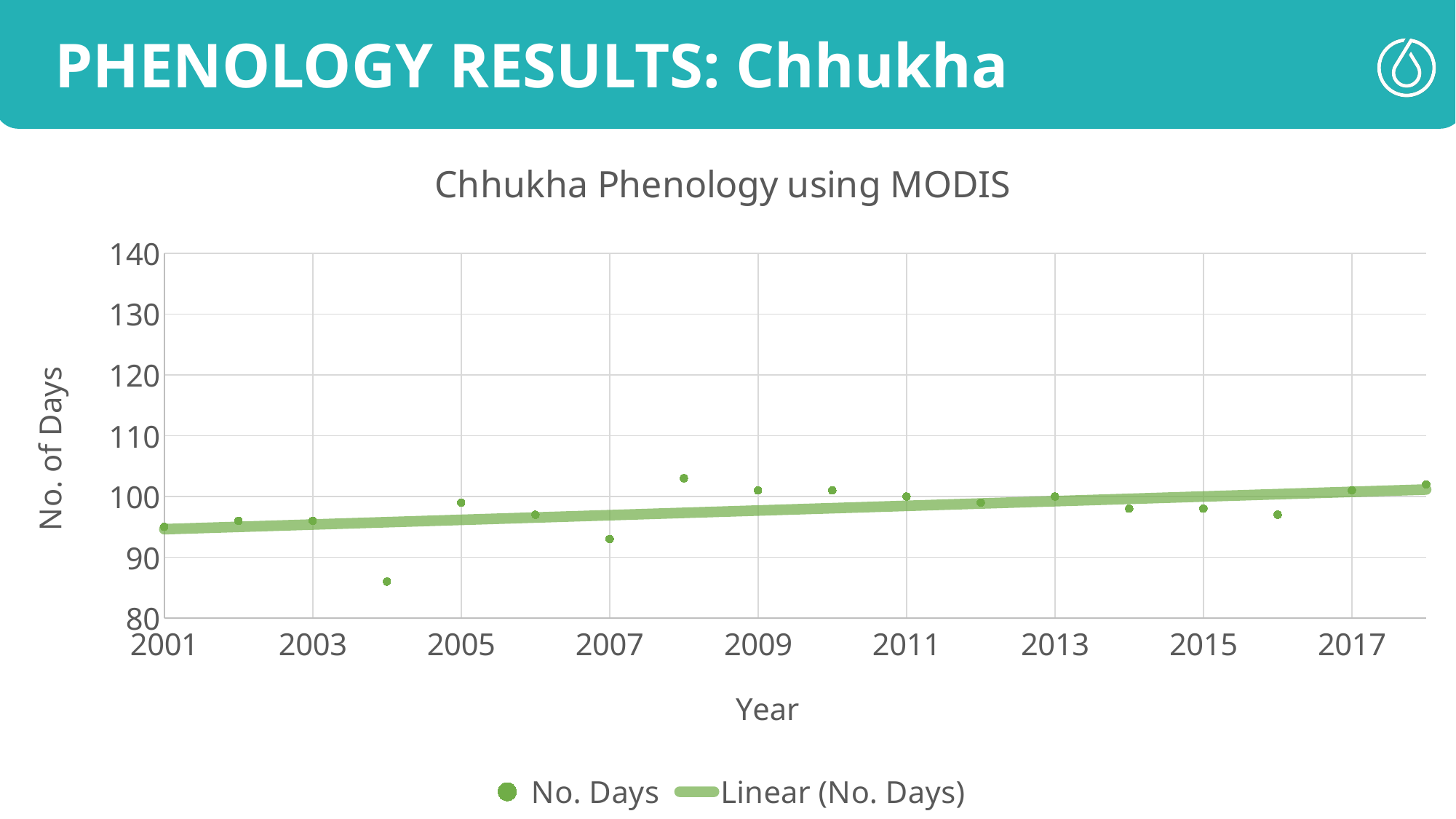
Which year has the larger value, 2007 or 2009? 2009 Is the value for 2008 greater or less than 100? greater Which year has the lowest number of days? 2004 What kind of chart is shown on the slide? Scatter chart Does the linear trendline rise or fall from 2001 to 2018? Rises Which year has the larger value, 2004 or 2008? 2008 Is the value for 2004 greater or less than 90? less Which year has the highest number of days? 2008 What is the title of the chart? Chhukha Phenology using MODIS Is the value for 2007 greater or less than 90? greater What is the label on the vertical axis? No. of Days How many series does the legend list? 2